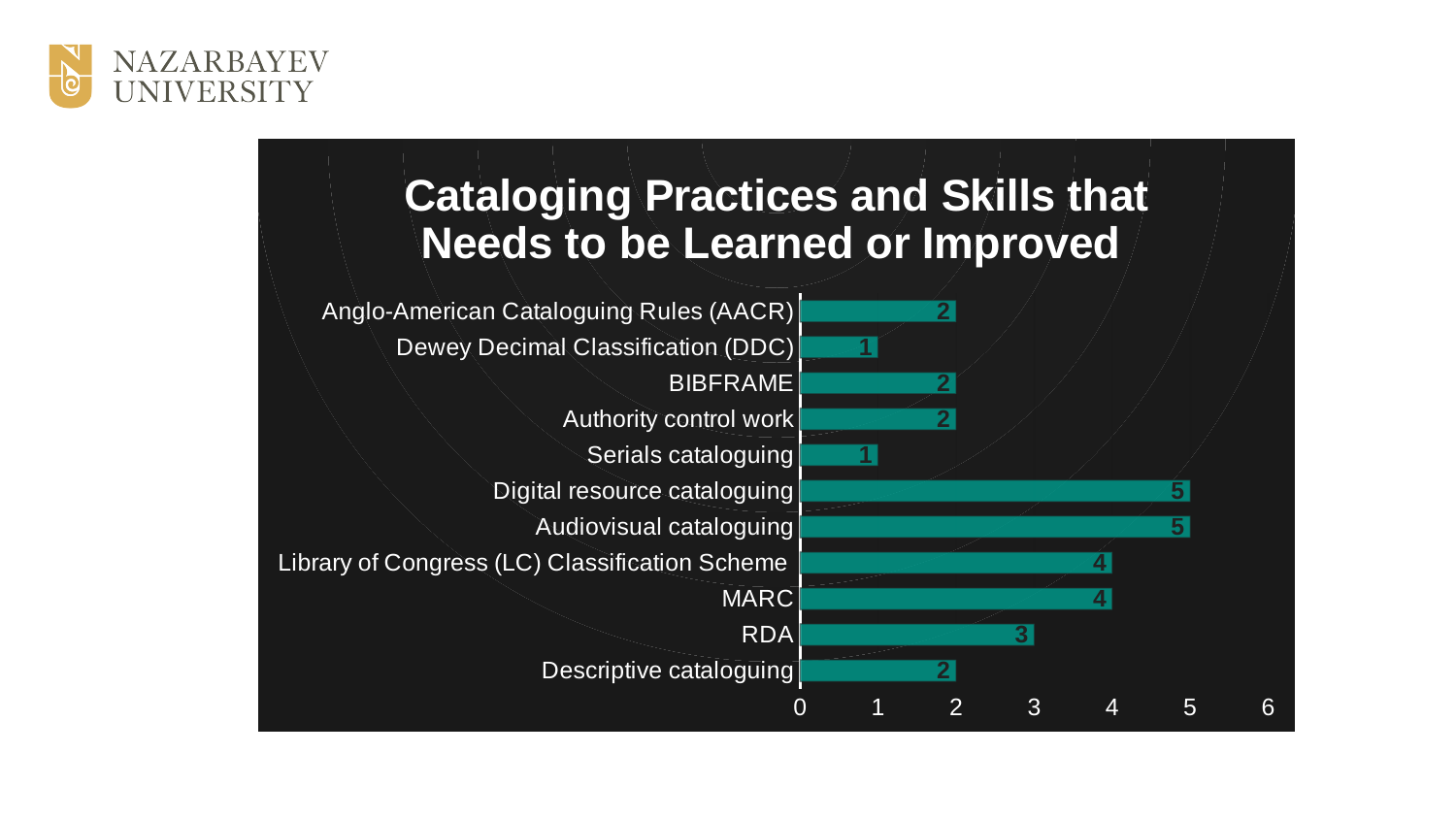
Which is larger, the value for MARC or the value for BIBFRAME? MARC Which categories have the highest value? Digital resource cataloguing and Audiovisual cataloguing Which categories have the lowest value? Dewey Decimal Classification (DDC) and Serials cataloguing What is the value for Dewey Decimal Classification (DDC)? 1 What is the title of the chart? Cataloging Practices and Skills that Needs to be Learned or Improved What is the difference between the values for Audiovisual cataloguing and RDA? 2 What is the value for Digital resource cataloguing? 5 How many categories are shown in the chart? 11 What is the value for MARC? 4 What is the value for RDA? 3 What kind of chart is shown on the slide? Bar chart Is the value for Library of Congress (LC) Classification Scheme greater or less than 3? greater